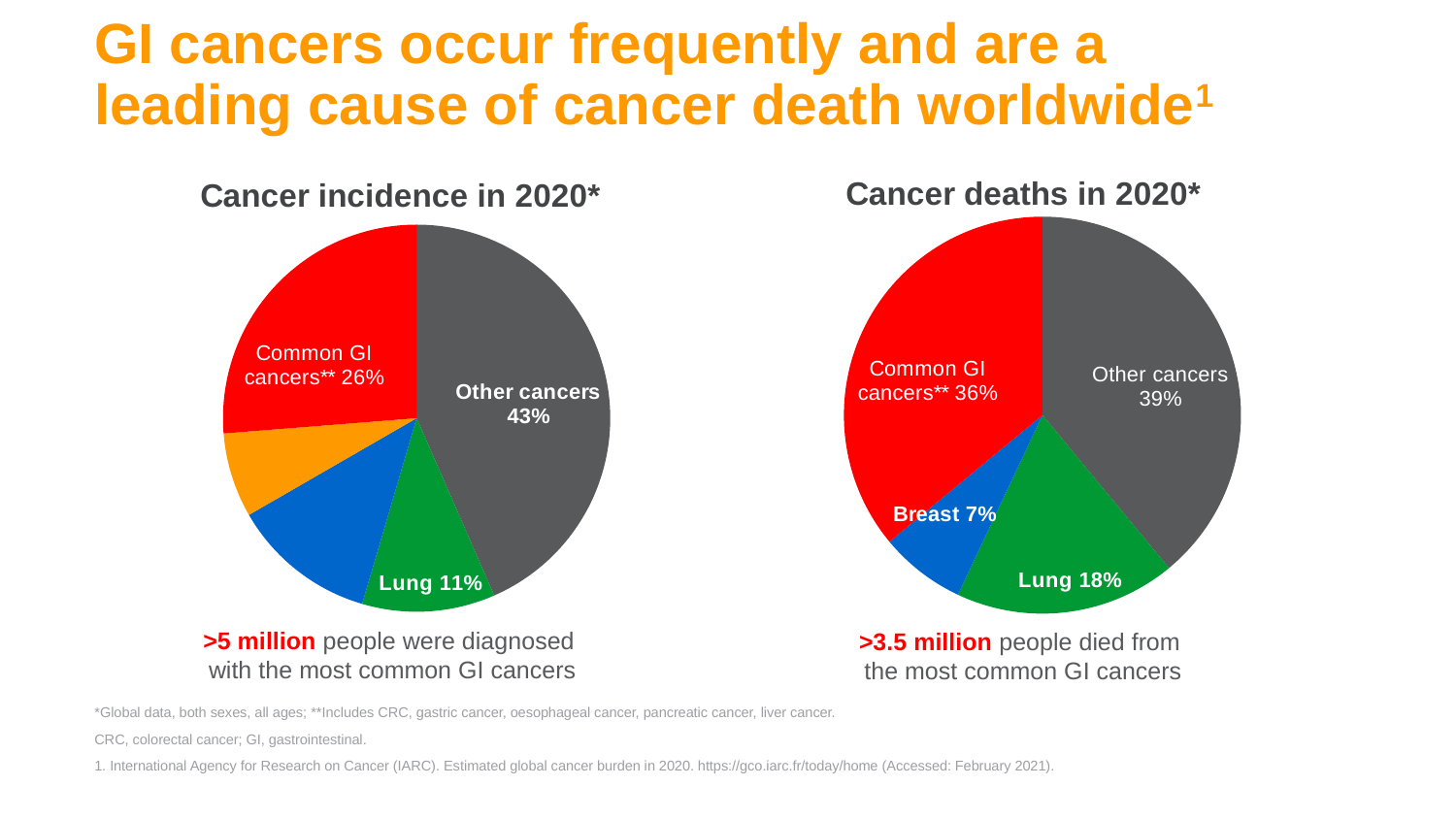
In the 'Cancer incidence in 2020*' chart, what share do Common GI cancers** account for? 26% In the 'Cancer deaths in 2020*' chart, which is larger: Lung or Breast? Lung What type of chart is used for 'Cancer incidence in 2020*'? Pie chart In the 'Cancer incidence in 2020*' chart, what is the difference between Other cancers and Common GI cancers**? 17% In the 'Cancer deaths in 2020*' chart, what share do Common GI cancers** account for? 36% In the 'Cancer incidence in 2020*' chart, what is the value for Other cancers? 43% How many slices does the 'Cancer deaths in 2020*' pie chart have? 4 In the 'Cancer incidence in 2020*' chart, which slice is the largest? Other cancers In the 'Cancer deaths in 2020*' chart, what is the value for Breast? 7% In the 'Cancer deaths in 2020*' chart, which slice is the smallest? Breast In the 'Cancer deaths in 2020*' chart, what is the value for Lung? 18% In the 'Cancer incidence in 2020*' chart, what is the value for Lung? 11%